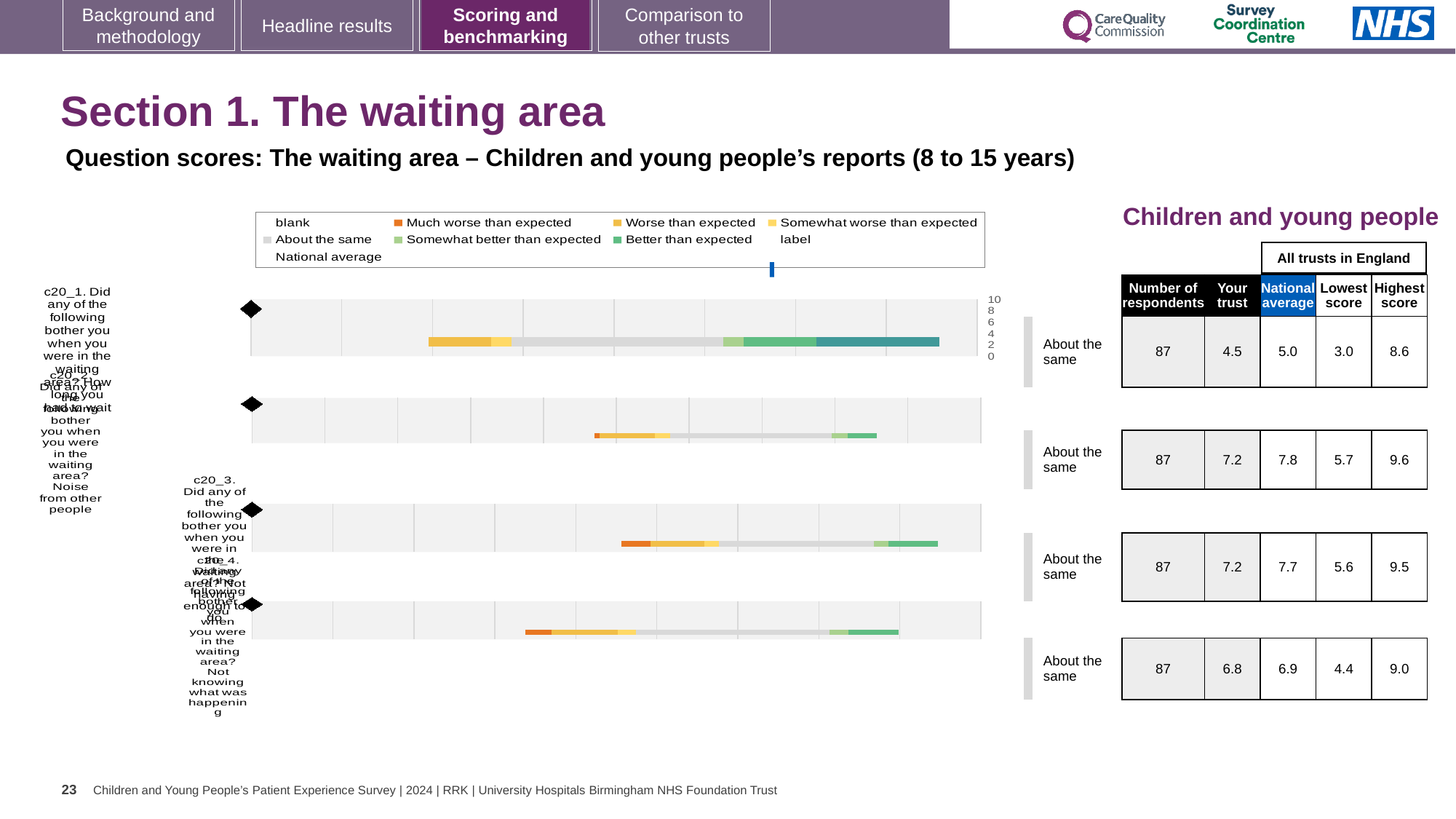
How many entries does the legend above the question score charts list? 9 What benchmark category is shown beside the chart for question c20_1? About the same Which legend entry is shown with an orange marker? Much worse than expected In the table next to the charts, what is the 'Your trust' score for question c20_2 (how long you had to wait)? 7.2 In the table next to the charts, which question has the lowest 'Your trust' score? c20_1 In the table next to the charts, what is the number of respondents for question c20_1? 87 How many question score charts (one per question) are shown on the slide? 4 In the table next to the charts, what is the difference between the highest score and the lowest score for question c20_1? 5.6 In the table next to the charts, which question has the highest 'Highest score' value? c20_2 In the table next to the charts, what is the national average for question c20_4 (not knowing what was happening)? 6.9 What kind of chart is used to show the question scores for the waiting area? bar chart For question c20_3, is the 'Your trust' score higher or lower than the national average? lower